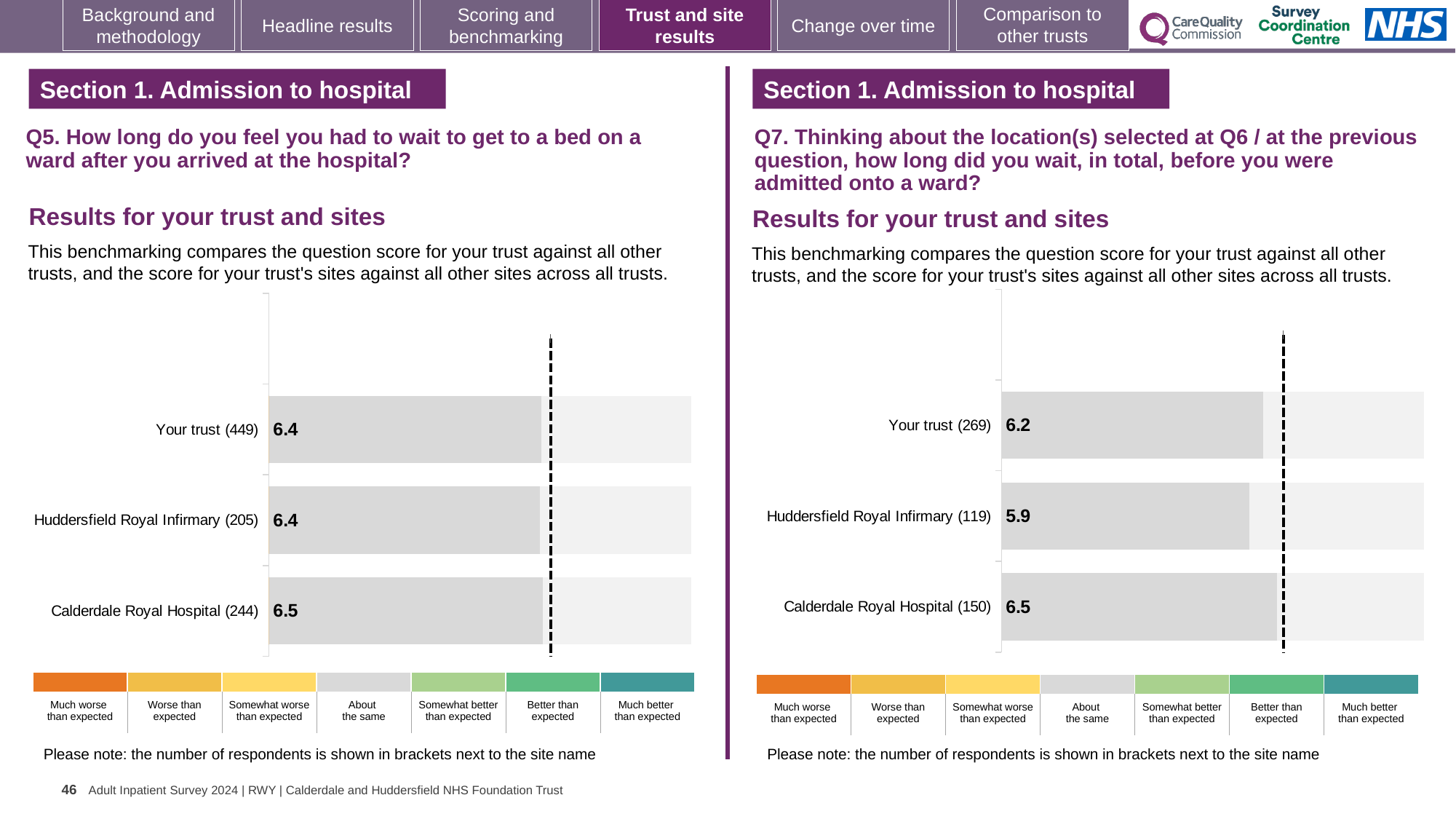
In the Q5 chart on the left, what is the difference between the scores for Calderdale Royal Hospital and Your trust? 0.1 In the Q5 chart on the left, what is the score for Your trust? 6.4 In the Q7 chart on the right, what is the score for Huddersfield Royal Infirmary? 5.9 What type of chart is used for the Q7 results on the right? Bar chart In the Q7 chart on the right, what is the score for Your trust? 6.2 In the Q7 chart on the right, which has the larger score: Your trust or Calderdale Royal Hospital? Calderdale Royal Hospital How many bars are plotted in the Q5 chart on the left? 3 In the Q7 chart on the right, what is the difference between the scores for Calderdale Royal Hospital and Huddersfield Royal Infirmary? 0.6 In the Q5 chart on the left, what is the score for Calderdale Royal Hospital? 6.5 In the Q7 chart on the right, which site or trust has the highest score? Calderdale Royal Hospital In the Q5 chart on the left, how many respondents are shown in brackets for Huddersfield Royal Infirmary? 205 In the Q7 chart on the right, which site or trust has the lowest score? Huddersfield Royal Infirmary